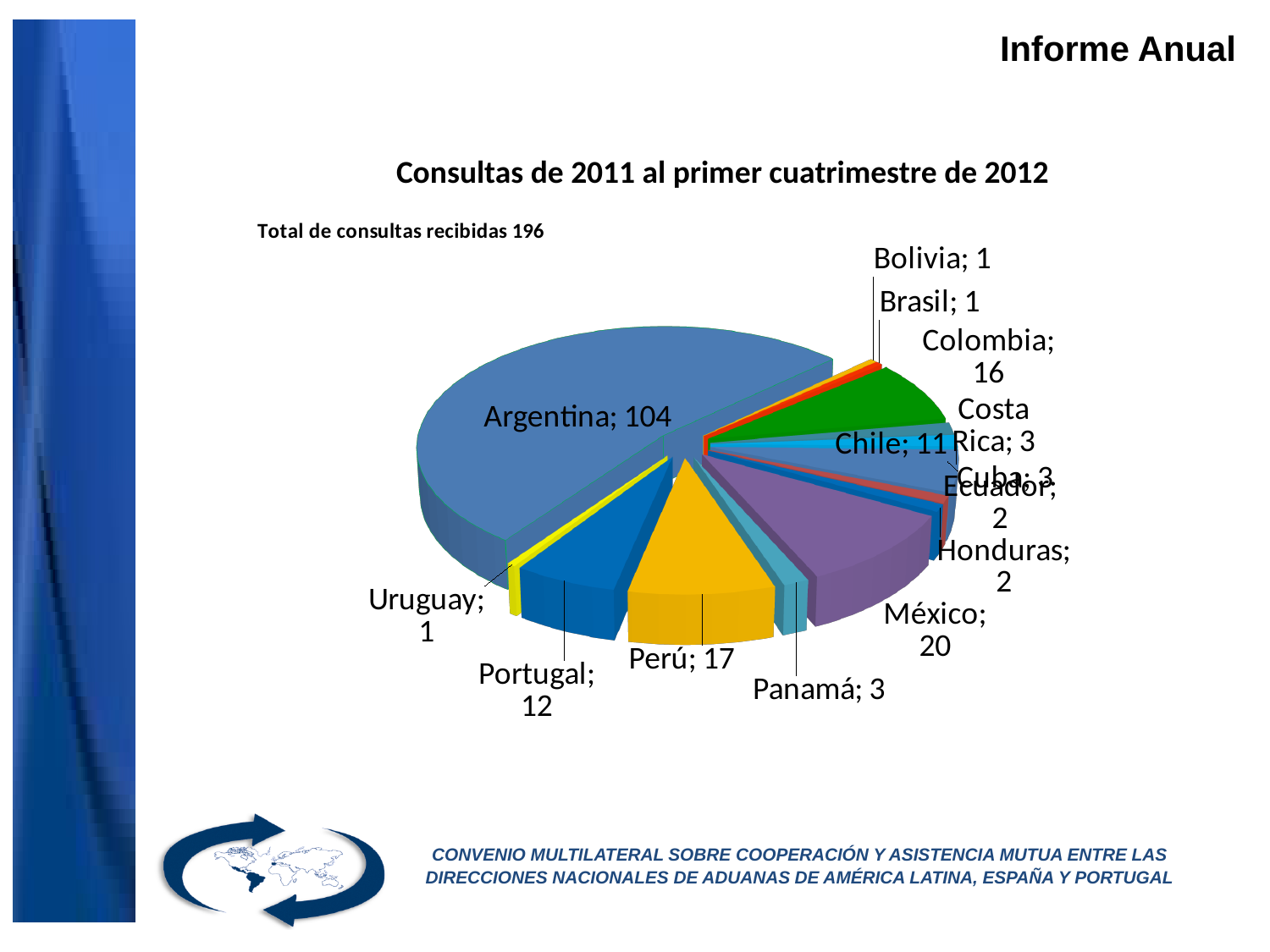
Which country has the largest slice of the pie? Argentina Which has a higher value, Chile or Portugal? Portugal What type of chart is shown on the slide? Pie chart What is the difference between the values for Argentina and México? 84 How many consultas does the chart show for Argentina? 104 What is the difference between the values for Perú and Colombia? 1 What is the value shown for Panamá? 3 What is the total number of consultas recibidas stated on the chart? 196 What is the title of the chart? Consultas de 2011 al primer cuatrimestre de 2012 What is the value shown for México? 20 How many countries (slices) are shown in the pie chart? 14 What is the value shown for Portugal? 12